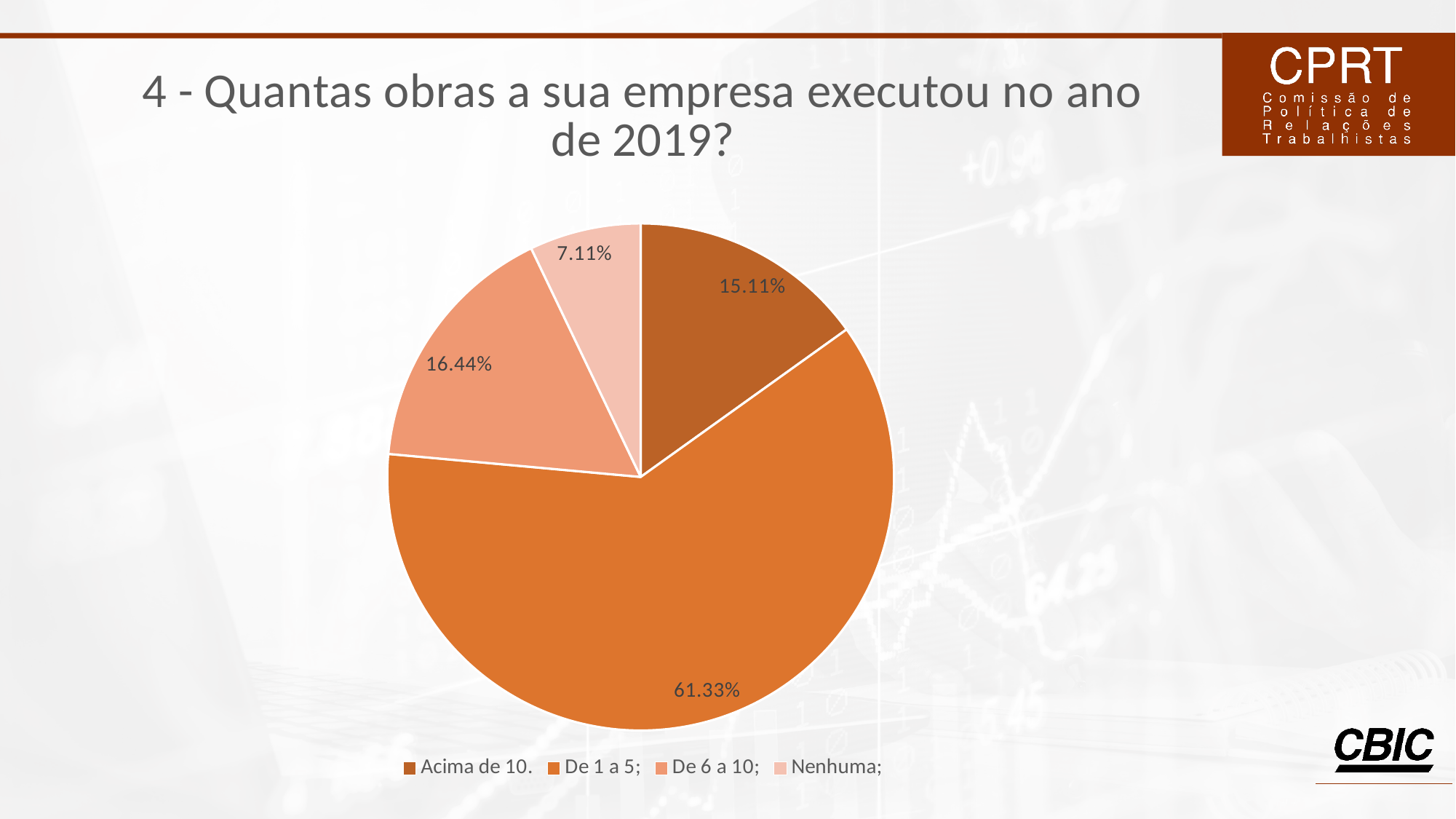
What is the difference in percentage points between 'De 1 a 5' and 'Acima de 10'? 46.22 How many categories does the pie chart have? 4 What is the difference in percentage points between 'De 6 a 10' and 'Nenhuma'? 9.33 What percentage of the pie corresponds to 'Nenhuma'? 7.11% Which category has the smallest slice of the pie? Nenhuma What is the title of the chart? 4 - Quantas obras a sua empresa executou no ano de 2019? What percentage of the pie corresponds to 'De 1 a 5'? 61.33% What percentage of the pie corresponds to 'Acima de 10'? 15.11% What percentage of the pie corresponds to 'De 6 a 10'? 16.44% Which is larger, the slice for 'De 6 a 10' or the slice for 'Acima de 10'? De 6 a 10 Which category has the largest slice of the pie? De 1 a 5 What kind of chart is shown on the slide? pie chart